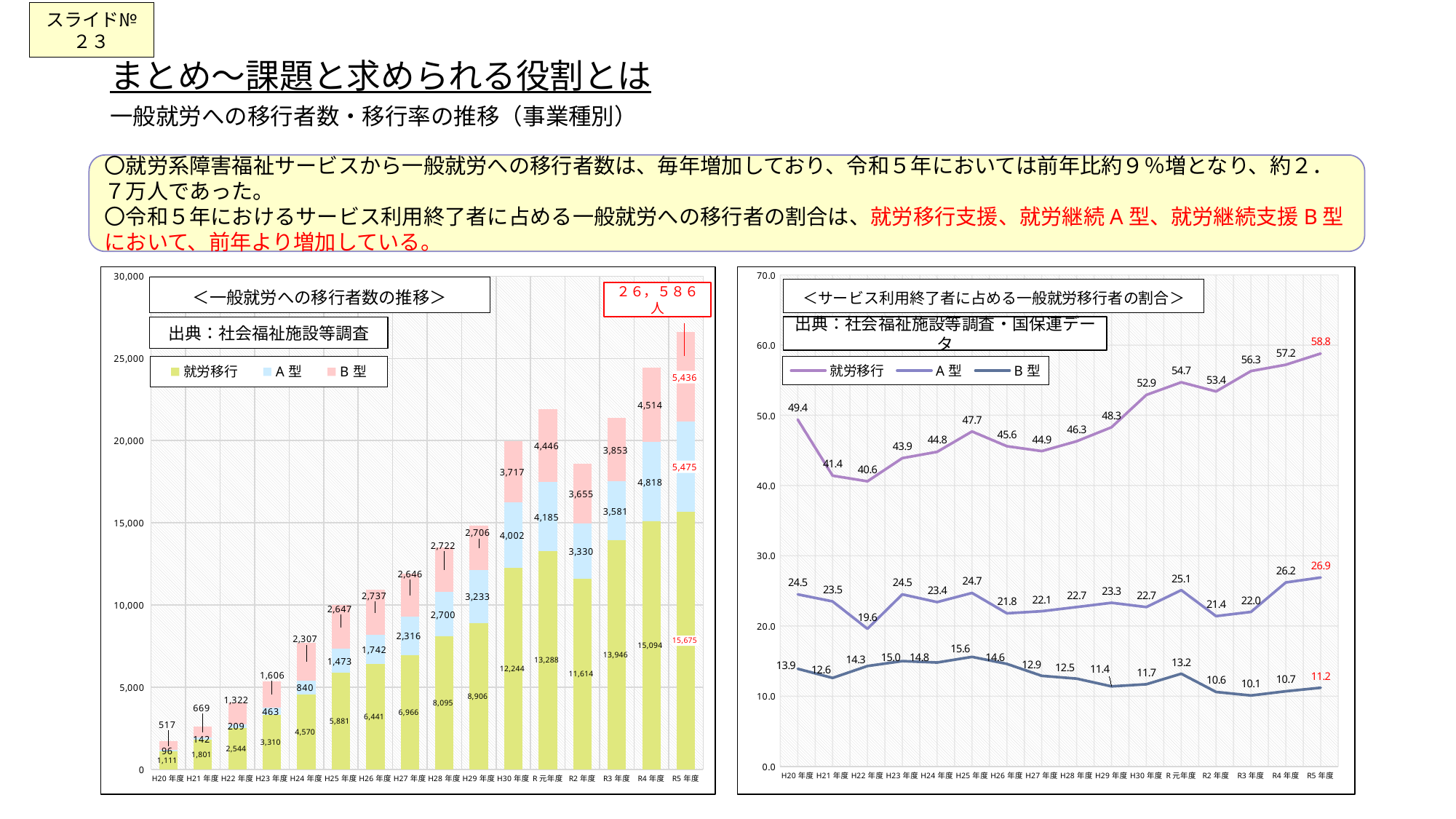
In the left chart ＜一般就労への移行者数の推移＞, what is the difference between the B型 value in R5年度 and in R4年度? 922 In the right chart ＜サービス利用終了者に占める一般就労移行者の割合＞, which fiscal year has the highest 就労移行 value? R5年度 What kind of chart is the right chart, ＜サービス利用終了者に占める一般就労移行者の割合＞? line chart In the left chart ＜一般就労への移行者数の推移＞, which fiscal year has the lowest A型 value? H20年度 How many series does the legend of the left chart ＜一般就労への移行者数の推移＞ list? 3 In the left chart ＜一般就労への移行者数の推移＞, what is the total shown for the R5年度 bar? 26,586人 In the left chart ＜一般就労への移行者数の推移＞, what is the value for 就労移行 in R5年度? 15,675 In the right chart ＜サービス利用終了者に占める一般就労移行者の割合＞, does the 就労移行 line rise or fall from R2年度 to R5年度? rise How many fiscal-year categories are plotted in the left chart ＜一般就労への移行者数の推移＞? 16 In the right chart ＜サービス利用終了者に占める一般就労移行者の割合＞, what is the A型 value for H22年度? 19.6 What kind of chart is the left chart, ＜一般就労への移行者数の推移＞? stacked bar chart In the right chart ＜サービス利用終了者に占める一般就労移行者の割合＞, which fiscal year has the lowest B型 value? R3年度